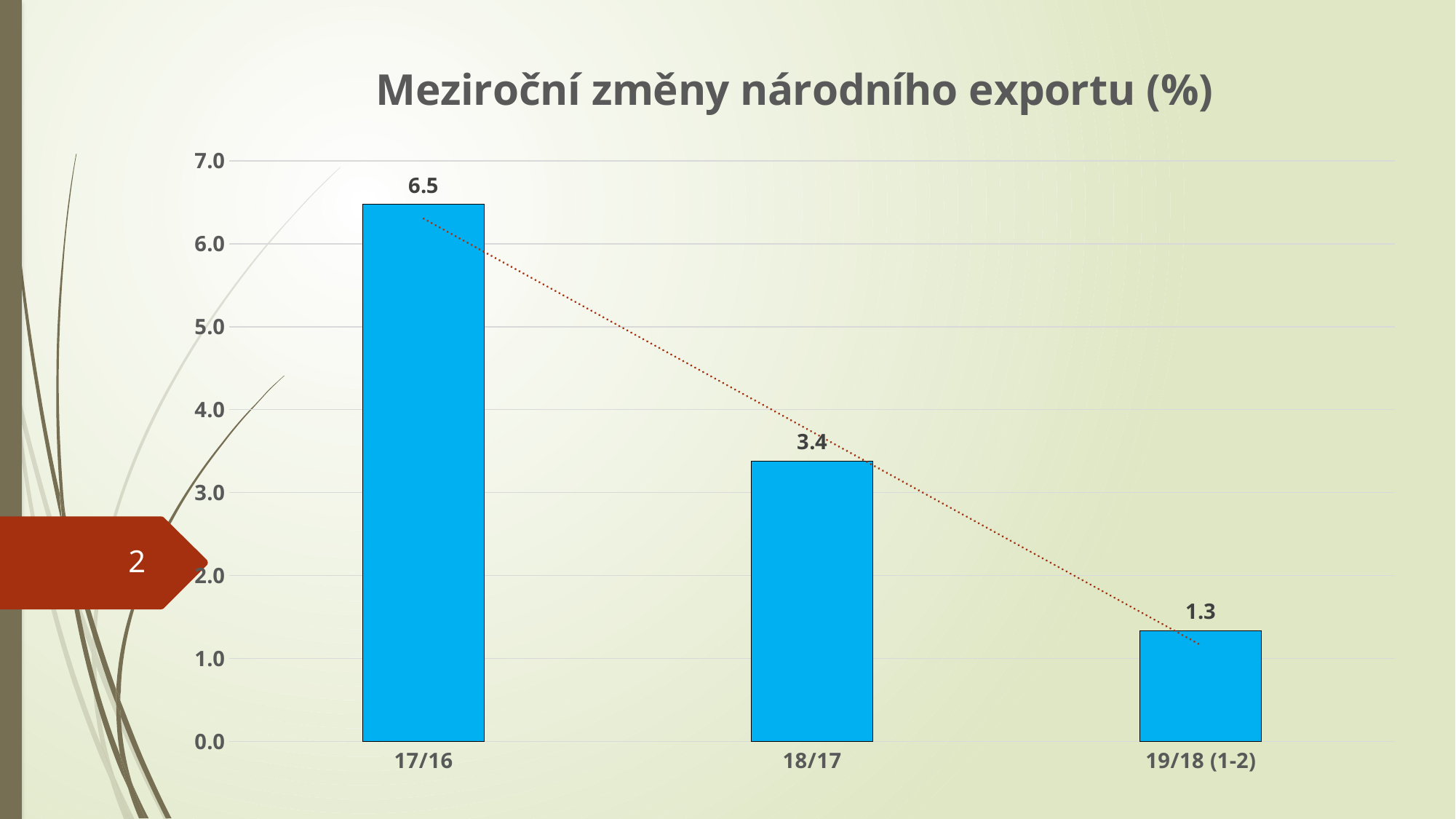
Is the value for 17/16 greater or less than 6.0? greater Do the values rise or fall from left to right along the x axis? fall What is the value for 19/18 (1-2)? 1.3 Which is larger, the value for 18/17 or the value for 19/18 (1-2)? 18/17 What is the value for 18/17? 3.4 What is the difference between the values for 17/16 and 18/17? 3.1 What is the value for 17/16? 6.5 Which category has the lowest value? 19/18 (1-2) Which category has the highest value? 17/16 What is the difference between the values for 18/17 and 19/18 (1-2)? 2.1 How many categories are shown on the x axis? 3 What kind of chart is shown on the slide? bar chart